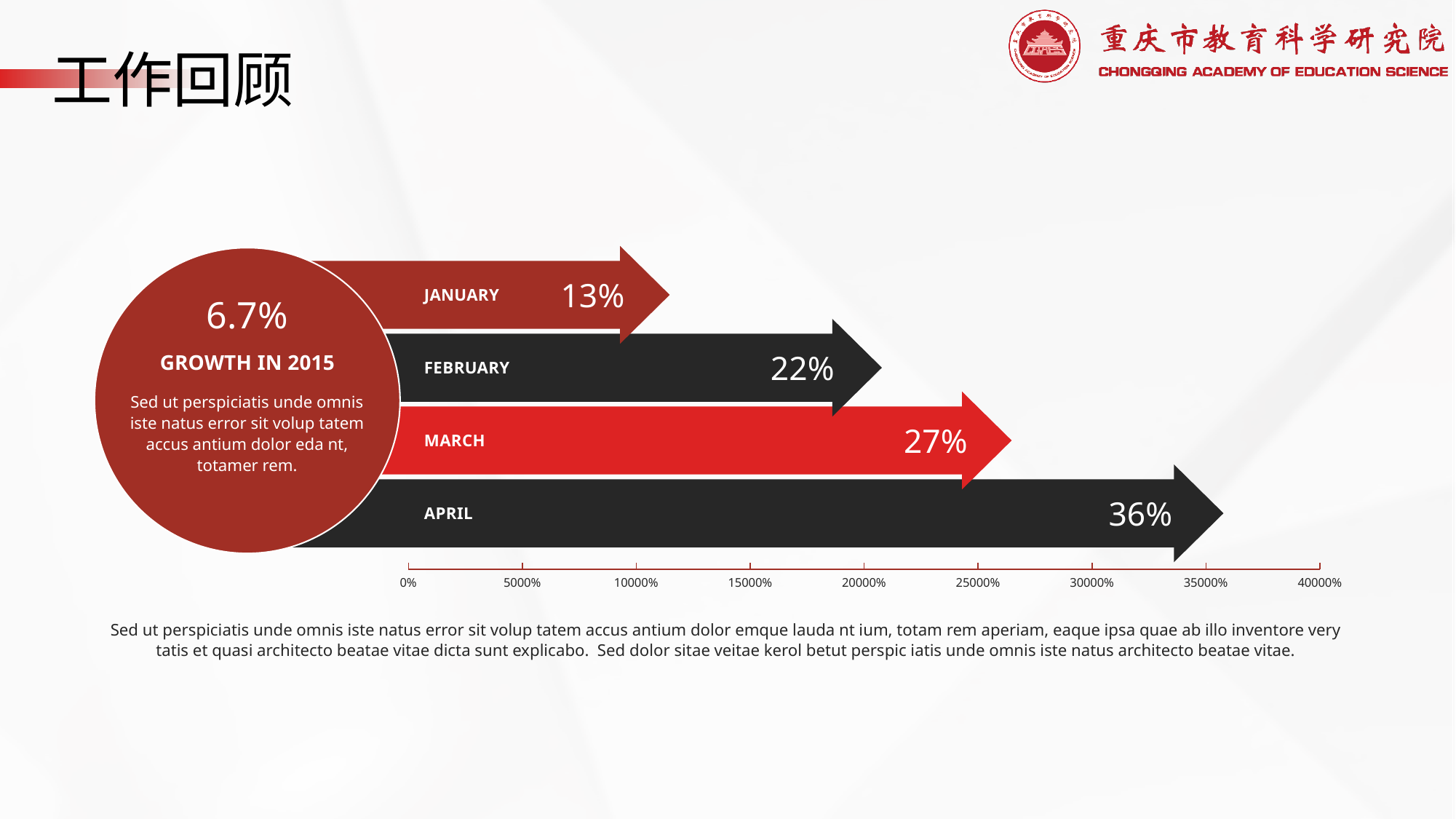
What is the difference between the values for April and January? 23% Which month has the highest value? April What is the difference between the values for March and February? 5% Do the values rise or fall from January to April? Rise Which month has the lowest value? January What kind of chart is shown on the slide? Bar chart What is the value for April? 36% What is the value for January? 13% How many months are shown in the chart? 4 Which is larger, the value for February or the value for March? March What is the value for February? 22% What is the value for March? 27%